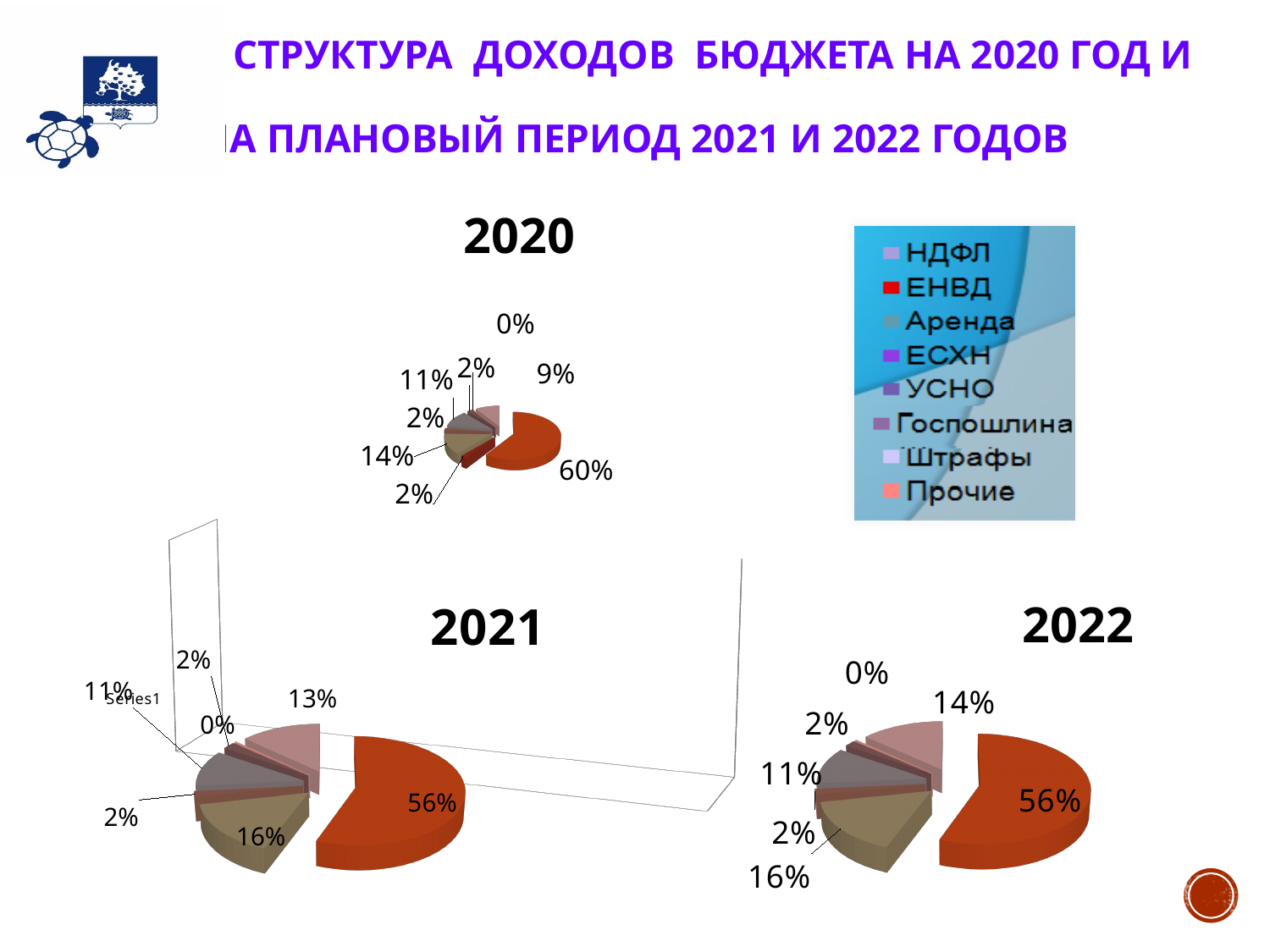
In the 2021 pie chart, what is the value of the second-largest slice? 16% How many data labels are shown on the 2020 pie chart? 8 In the 2022 pie chart, what is the value of the second-largest slice? 16% In the 2021 pie chart, what is the value of the largest slice? 56% What kind of charts are shown on the slide? Pie charts How many entries does the legend list? 8 What is the first entry listed in the legend? НДФЛ Which pie chart has the larger biggest slice, 2020 or 2022? 2020 What is the last entry listed in the legend? Прочие In the 2022 pie chart, what is the value of the largest slice? 56% By how many percentage points is the largest slice of the 2020 pie chart bigger than the largest slice of the 2021 pie chart? 4 percentage points In the 2020 pie chart, what is the value of the largest slice? 60%